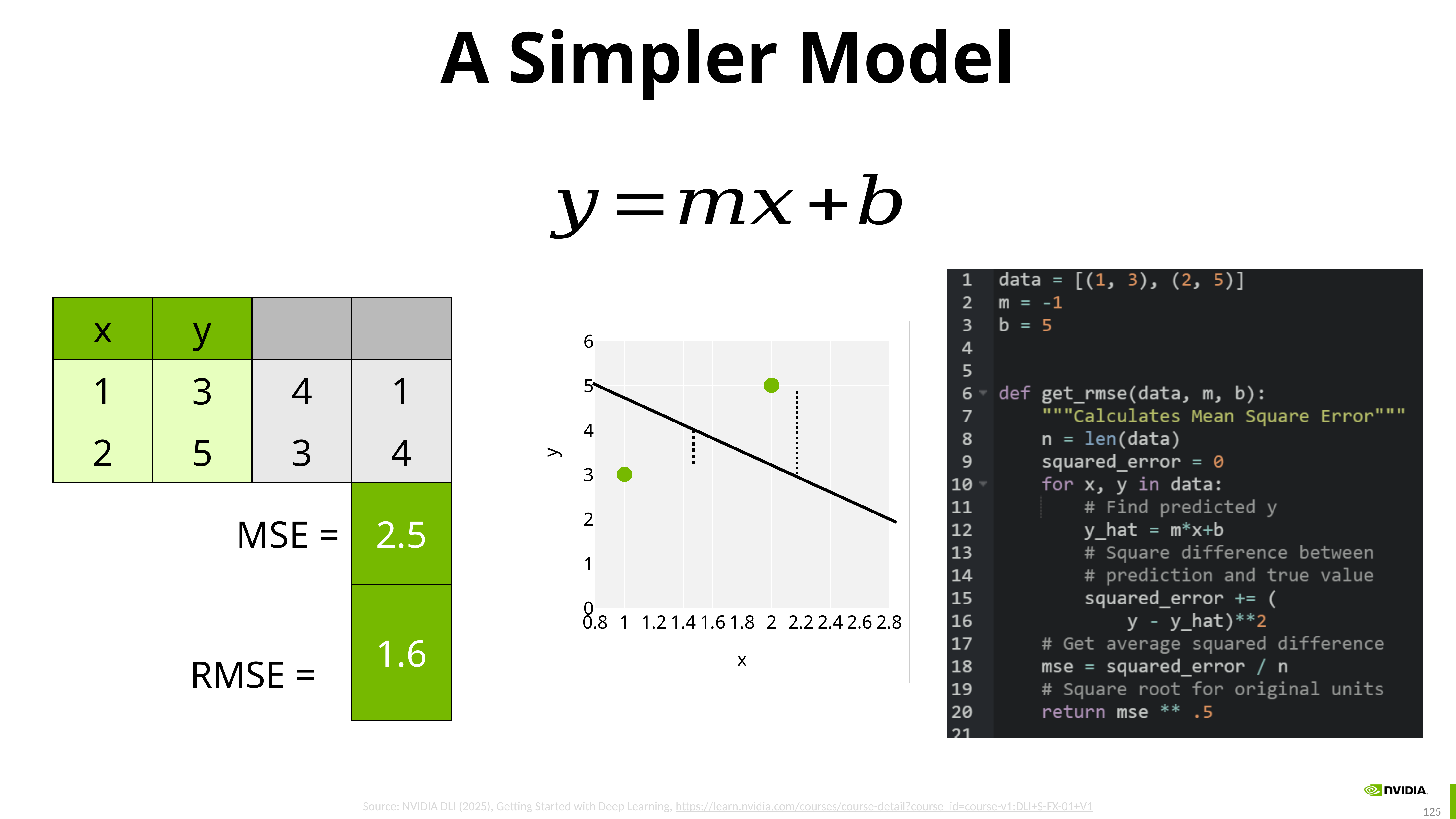
What is the label on the vertical axis of the chart? y At which x value does the plotted point have the lowest y value? 1 Is the value of the fitted line at x = 1.4 greater or less than 3? greater What is the difference between the y values of the points at x = 2 and x = 1? 2 Does the fitted line rise or fall as x increases? fall What is the y value of the plotted point at x = 2? 5 What is the y value of the plotted point at x = 1? 3 Which plotted point has the larger y value, the one at x = 1 or the one at x = 2? x = 2 Do the plotted points rise or fall as x increases? rise At which x value does the plotted point have the highest y value? 2 What kind of chart is shown on the slide? scatter chart How many data points are plotted in the chart? 2